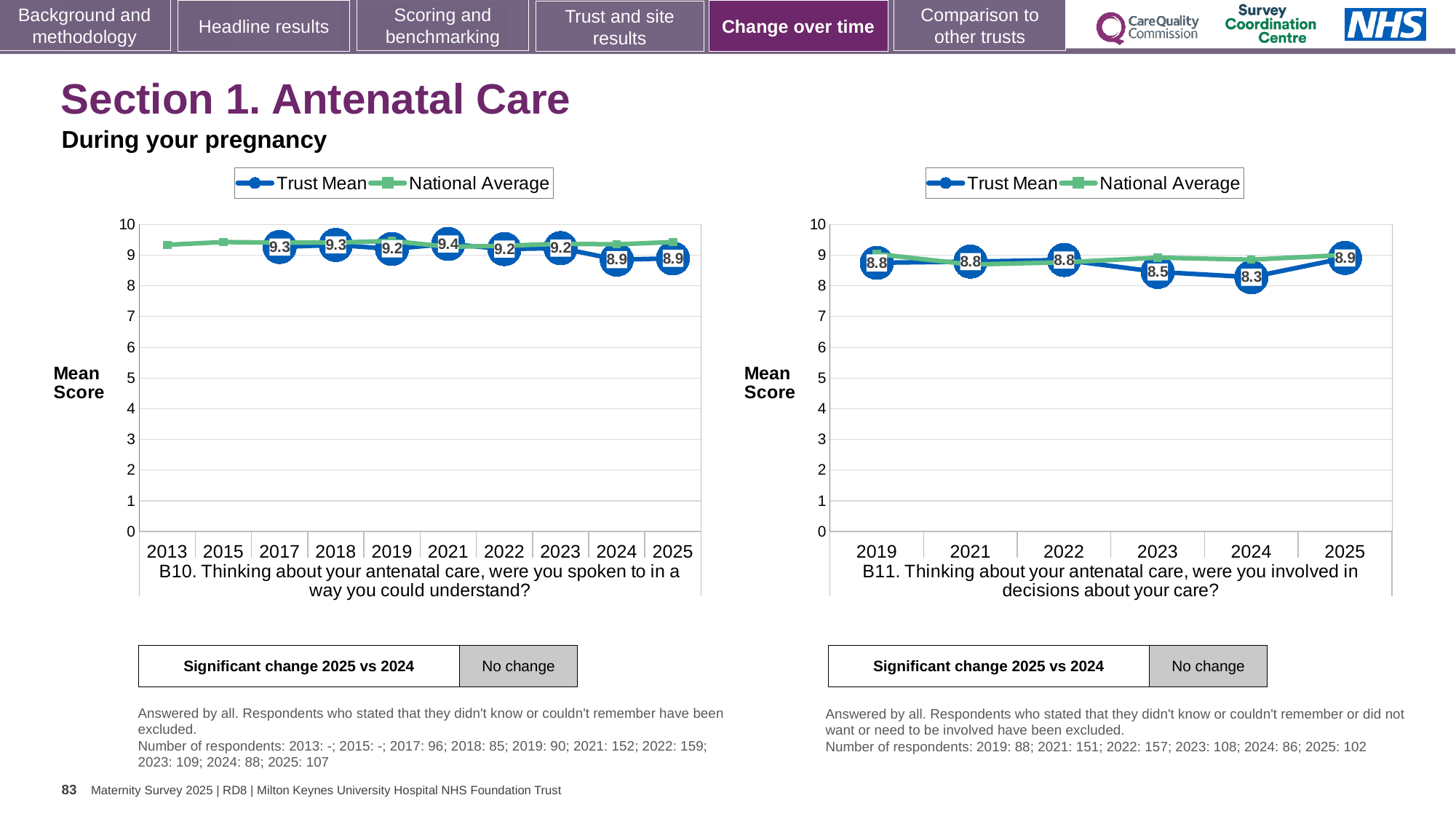
In the B10 chart on the left, is the National Average for 2013 greater or less than 9? greater How many series does the legend of the B11 chart on the right list? 2 In the B10 chart on the left, what is the Trust Mean for 2021? 9.4 In the B10 chart on the left, what is the difference between the Trust Mean in 2021 and in 2025? 0.5 In the B10 chart on the left, which year has the highest Trust Mean? 2021 In the B11 chart on the right, what is the difference between the Trust Mean in 2025 and in 2024? 0.6 In the B11 chart on the right, is the Trust Mean higher in 2022 or in 2023? 2022 In the B11 chart on the right, what is the Trust Mean for 2024? 8.3 In the B11 chart on the right, which year has the highest Trust Mean? 2025 In the B11 chart on the right, which year has the lowest Trust Mean? 2024 What type of chart is the B11 chart on the right? Line chart How many years are shown on the x axis of the B10 chart on the left? 10